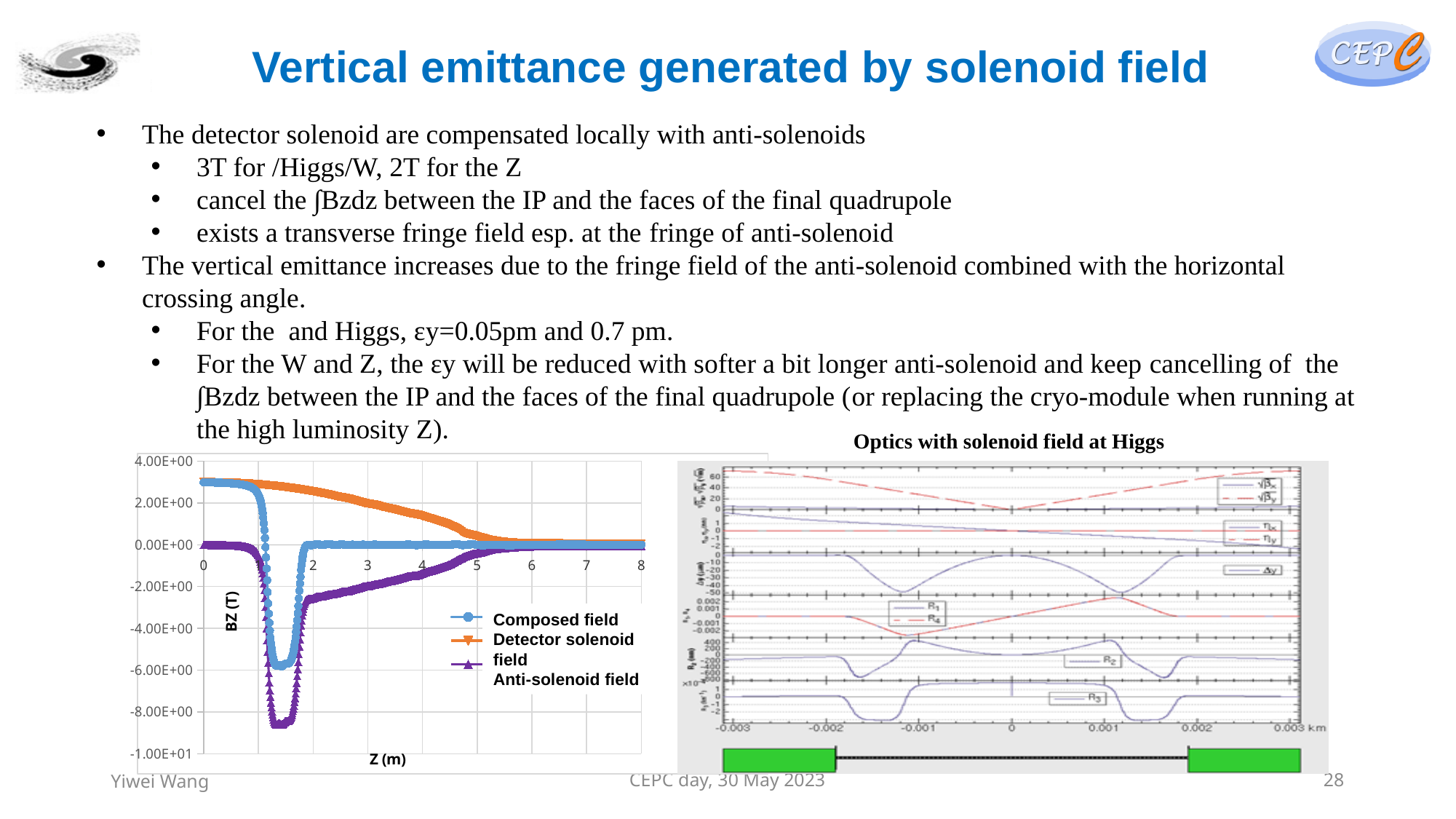
How many series does the legend of the left chart list? 3 In the left chart, is the minimum value of the Composed field greater or less than -4.00E+00? less In the left chart, which series reaches the lowest value? Anti-solenoid field What kind of chart is the BZ (T) versus Z (m) chart on the left of the slide? line chart In the left chart, is the Detector solenoid field at Z = 5 greater or less than 2.00E+00? less In the left chart, does the Detector solenoid field rise or fall as Z increases from 0 to 8? fall In the left chart, is the Detector solenoid field at Z = 0 greater or less than 2.00E+00? greater What are the three series named in the legend of the left chart? Composed field, Detector solenoid field, Anti-solenoid field What is the label of the vertical axis of the left chart? BZ (T) In the left chart, at Z = 0, which is larger: the Detector solenoid field or the Anti-solenoid field? Detector solenoid field What is the largest Z value labeled on the x axis of the left chart? 8